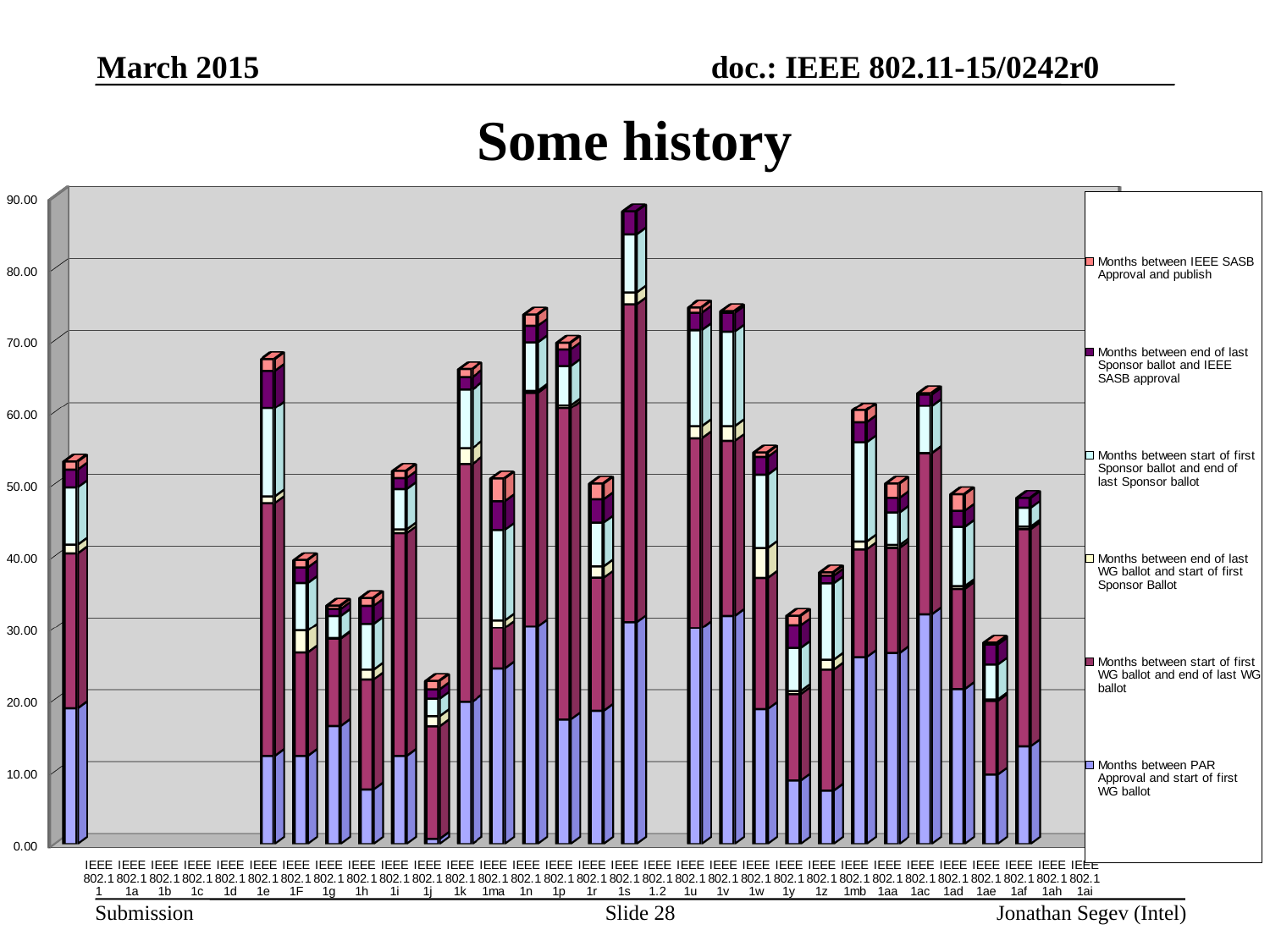
Which has the taller stacked bar, IEEE 802.11e or IEEE 802.11g? IEEE 802.11e How many categories are labelled on the x axis? 31 Is the total for IEEE 802.11s greater or less than 80.00? greater Which category has the tallest stacked bar? IEEE 802.11s Which has the taller stacked bar, IEEE 802.11ae or IEEE 802.11ac? IEEE 802.11ac Is the total for IEEE 802.11n greater or less than 70.00? greater How many series does the legend list? 6 Is the total for IEEE 802.11j greater or less than 30.00? less What does the legend say the bottom (blue) segment of each bar represents? Months between PAR Approval and start of first WG ballot What kind of chart is shown on the slide? Stacked bar chart